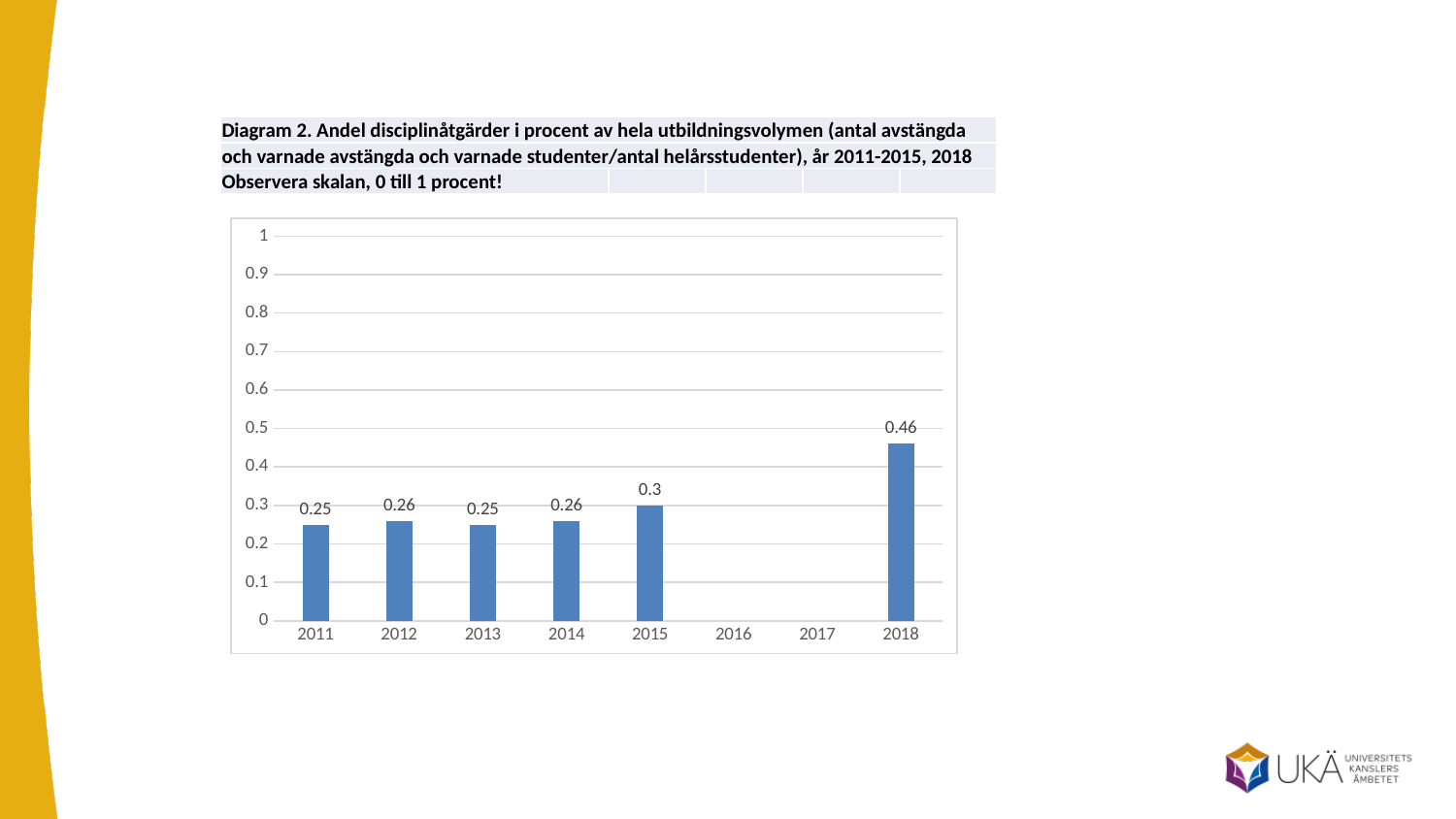
Which is larger, the value for 2015 or the value for 2012? 2015 What kind of chart is shown on the slide? bar chart What is the difference between the values for 2018 and 2011? 0.21 What is the value for 2015? 0.3 What is the value for 2012? 0.26 What is the value for 2018? 0.46 How many years have a bar plotted in the chart? 6 Which year has the highest value? 2018 What is the value for 2011? 0.25 What is the difference between the values for 2018 and 2015? 0.16 Is the value for 2018 greater or less than 0.5? less Which years on the x axis have no bar plotted? 2016 and 2017